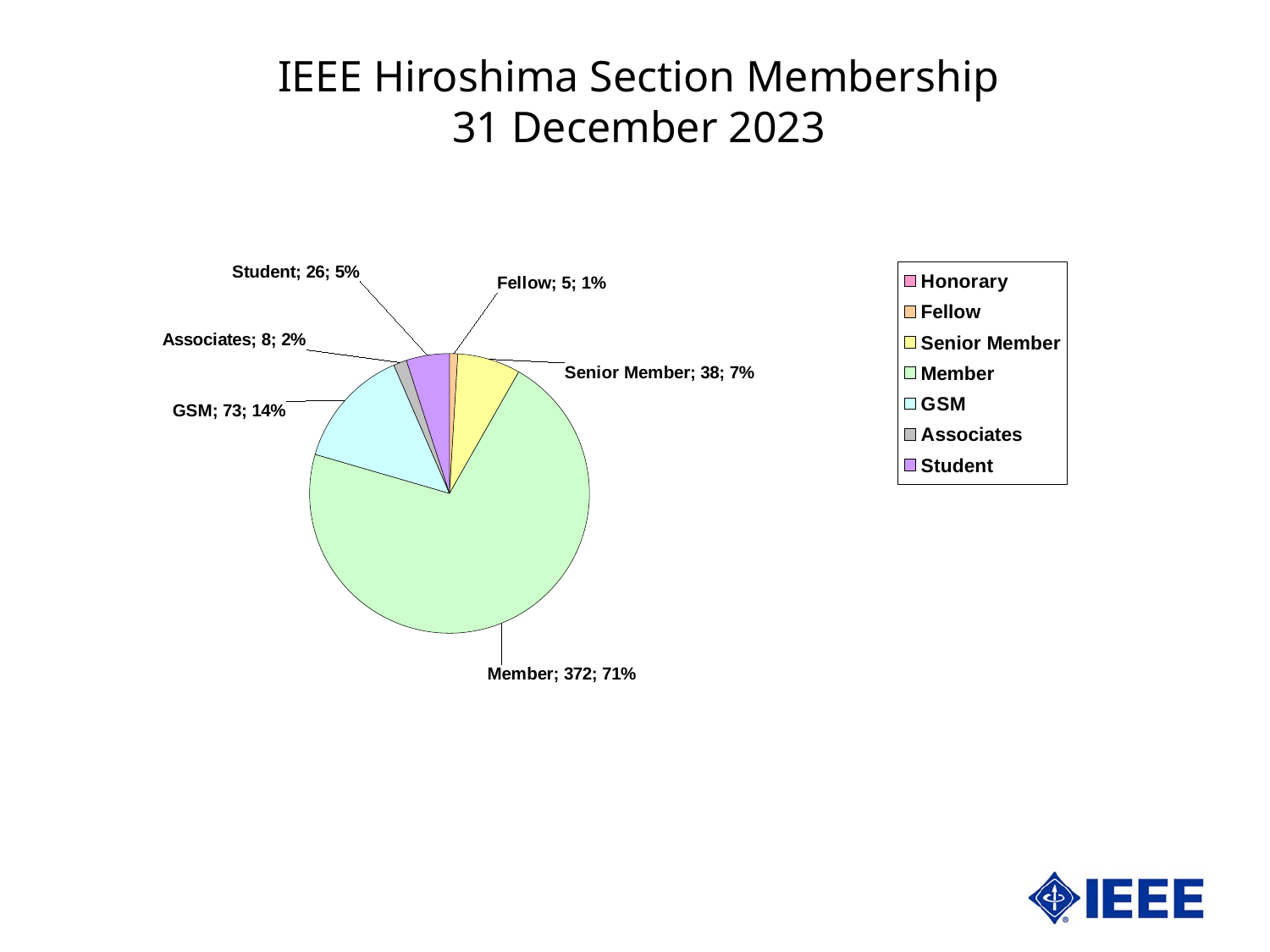
How many members are in the Member category? 372 How many entries does the legend list? 7 Which labeled category has the smallest slice? Fellow What share of the pie does the Member slice represent? 71% What type of chart is shown on the slide? pie chart What is the value shown for Senior Member? 38 What share of the pie does the GSM slice represent? 14% Which labeled category has the largest slice? Member What is the title of the chart on the slide? IEEE Hiroshima Section Membership 31 December 2023 What is the value shown for GSM? 73 What is the value shown for Fellow? 5 What is the difference between the GSM value and the Senior Member value? 35